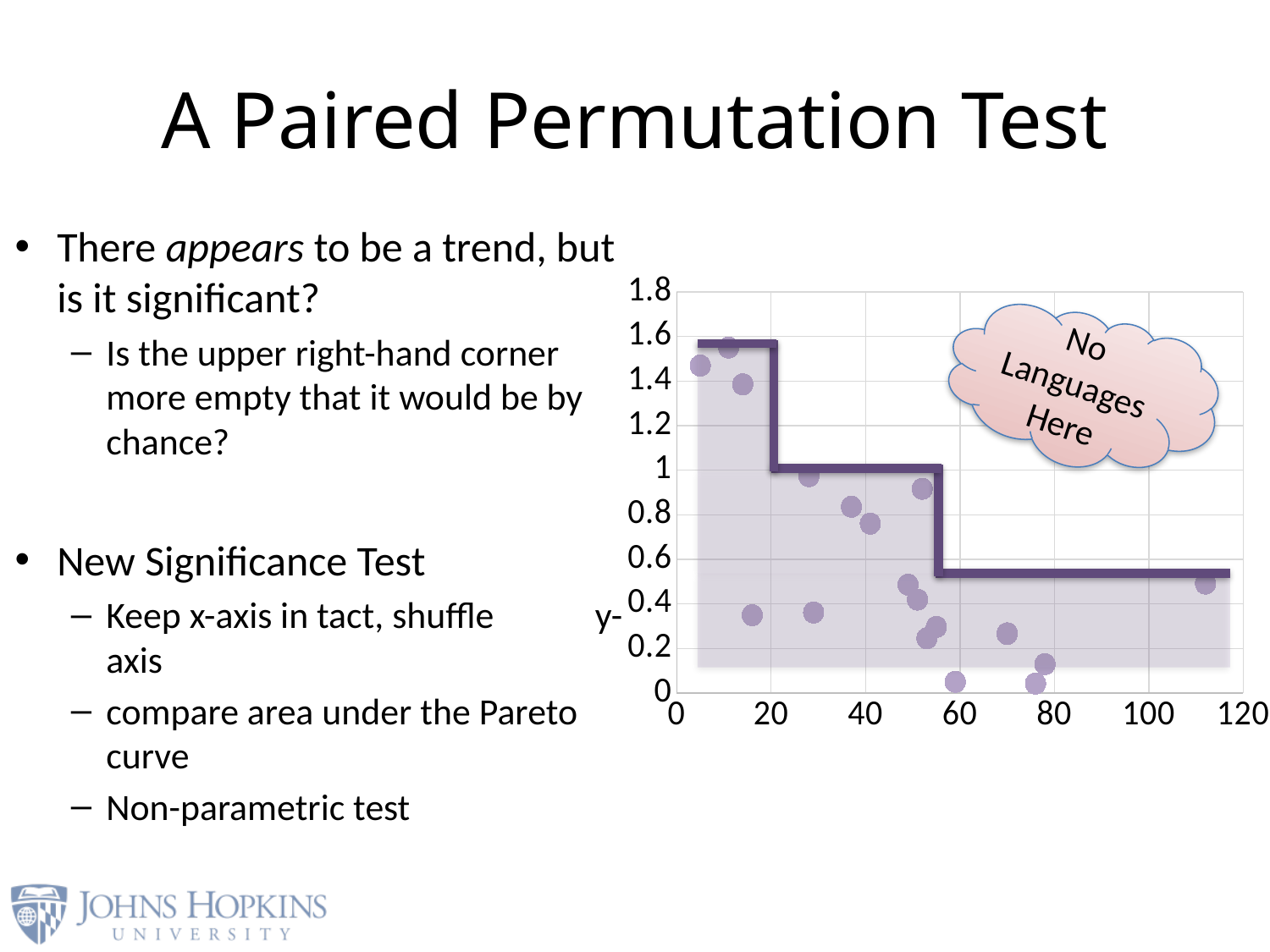
What is the highest value shown on the y-axis of the chart? 1.8 What kind of chart is shown on the slide? scatter chart Is the middle level of the step curve (between x = 20 and x = 55) greater or less than 0.8? greater What is the highest value shown on the x-axis of the chart? 120 Is the y value of the highest point near x = 10 greater or less than 1.4? greater Do the plotted points generally rise or fall as the x-axis value increases? fall Is the y value of the point near x = 113 greater or less than 0.6? less How many distinct horizontal levels does the step curve have? 3